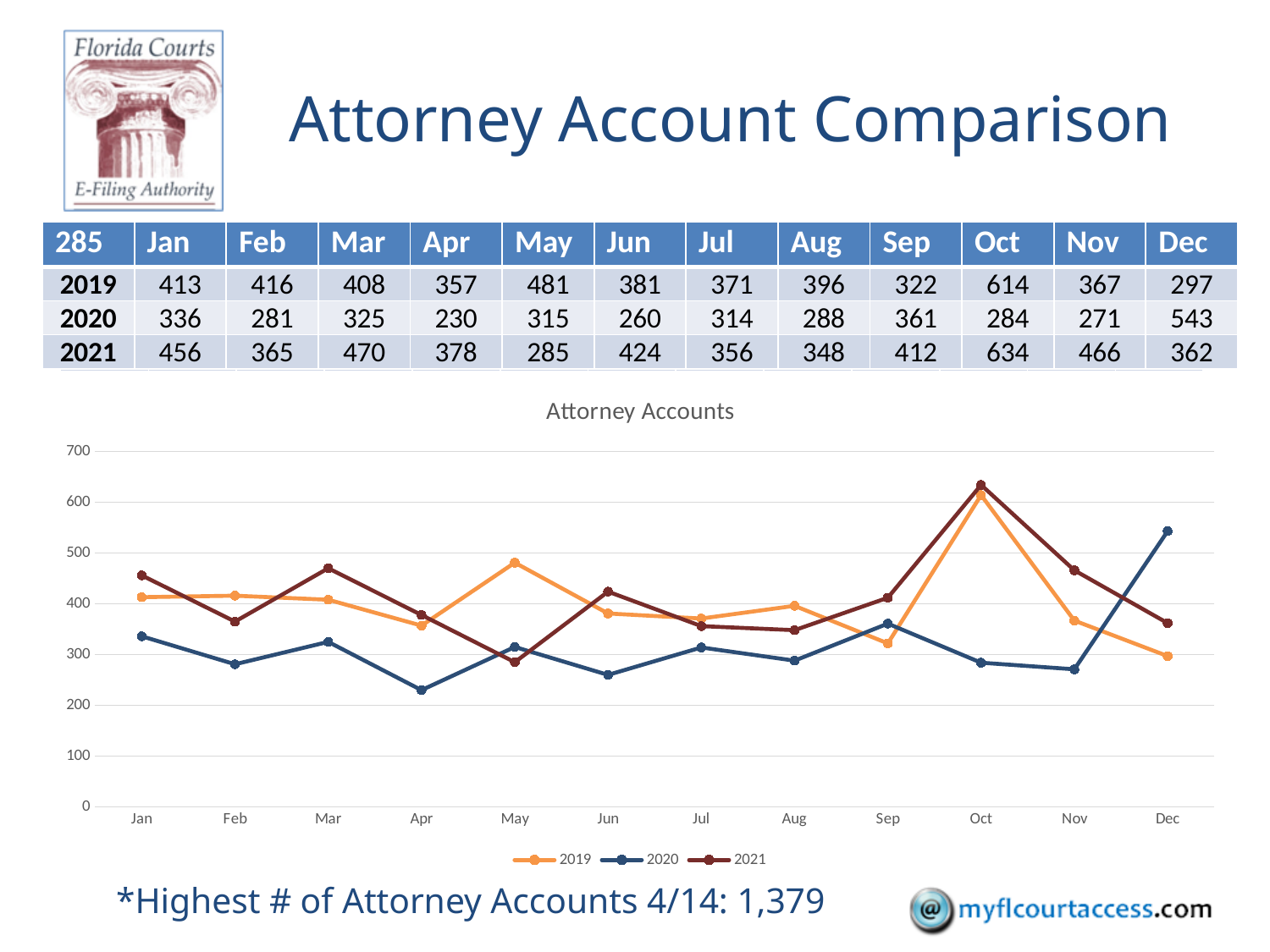
What kind of chart is the Attorney Accounts chart? line chart What is the value for 2021 in Jan on the Attorney Accounts chart? 456 What is the value for 2019 in Oct on the Attorney Accounts chart? 614 What is the difference between the 2020 and 2019 values in Dec? 246 Which series has the larger value in May, 2019 or 2021? 2019 Is the 2020 value for Dec greater or less than 500? greater In which month does the 2021 series reach its highest value? Oct In which month does the 2020 series reach its lowest value? Apr How many series does the legend of the Attorney Accounts chart list? 3 What is the value for 2020 in Apr on the Attorney Accounts chart? 230 What is the difference between the 2021 and 2019 values in Oct? 20 How many months are shown on the x axis of the Attorney Accounts chart? 12